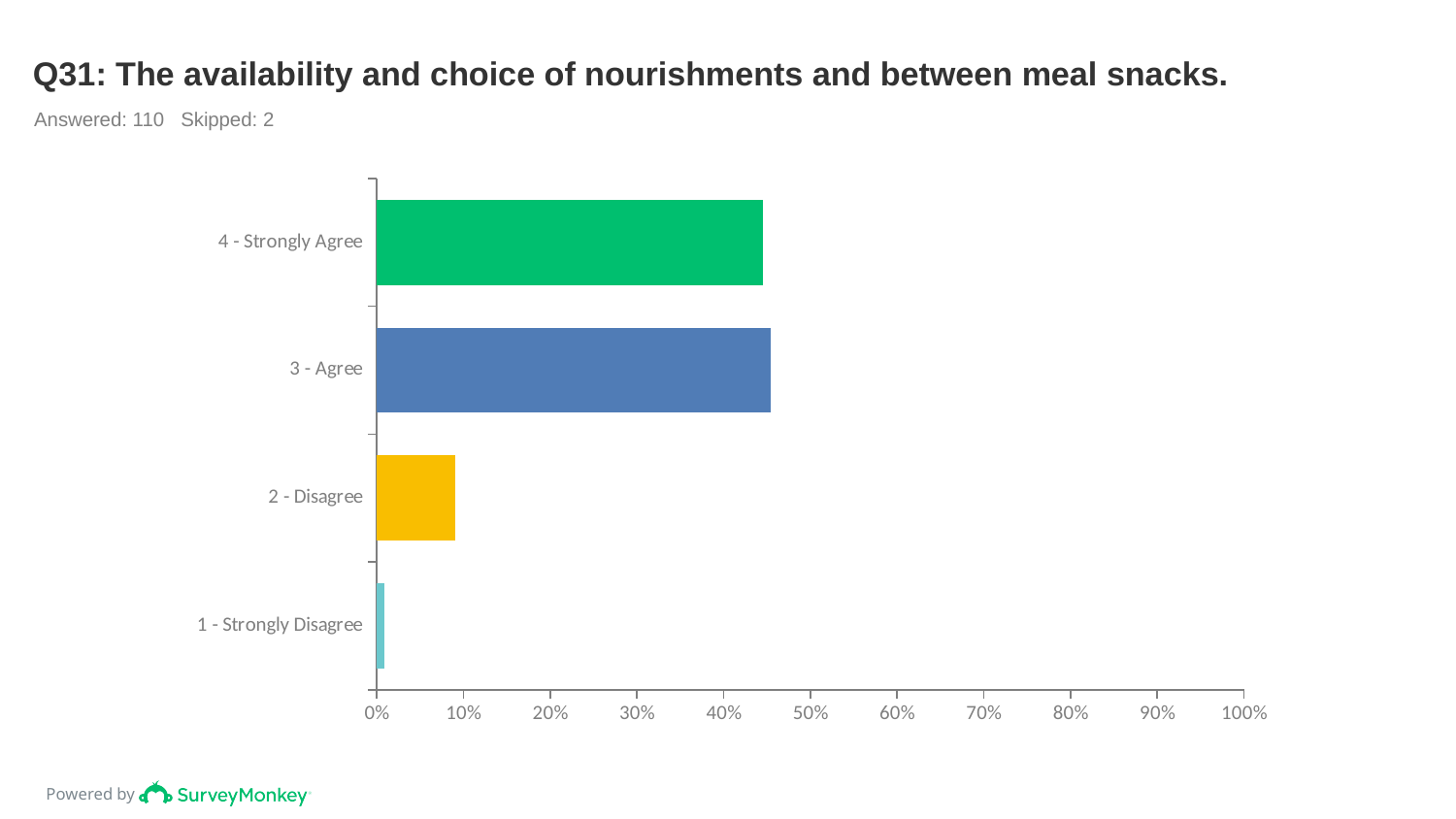
What is the title of the chart? Q31: The availability and choice of nourishments and between meal snacks. Is the value for 1 - Strongly Disagree greater or less than 10%? less Which category has the lowest value? 1 - Strongly Disagree Is the value for 3 - Agree greater or less than 50%? less Is the value for 3 - Agree greater or less than 40%? greater Which is larger, the value for 3 - Agree or the value for 2 - Disagree? 3 - Agree Which is larger, the value for 2 - Disagree or the value for 1 - Strongly Disagree? 2 - Disagree What kind of chart is shown on the slide? bar chart How many categories are plotted in the chart? 4 How many respondents answered the question according to the slide? 110